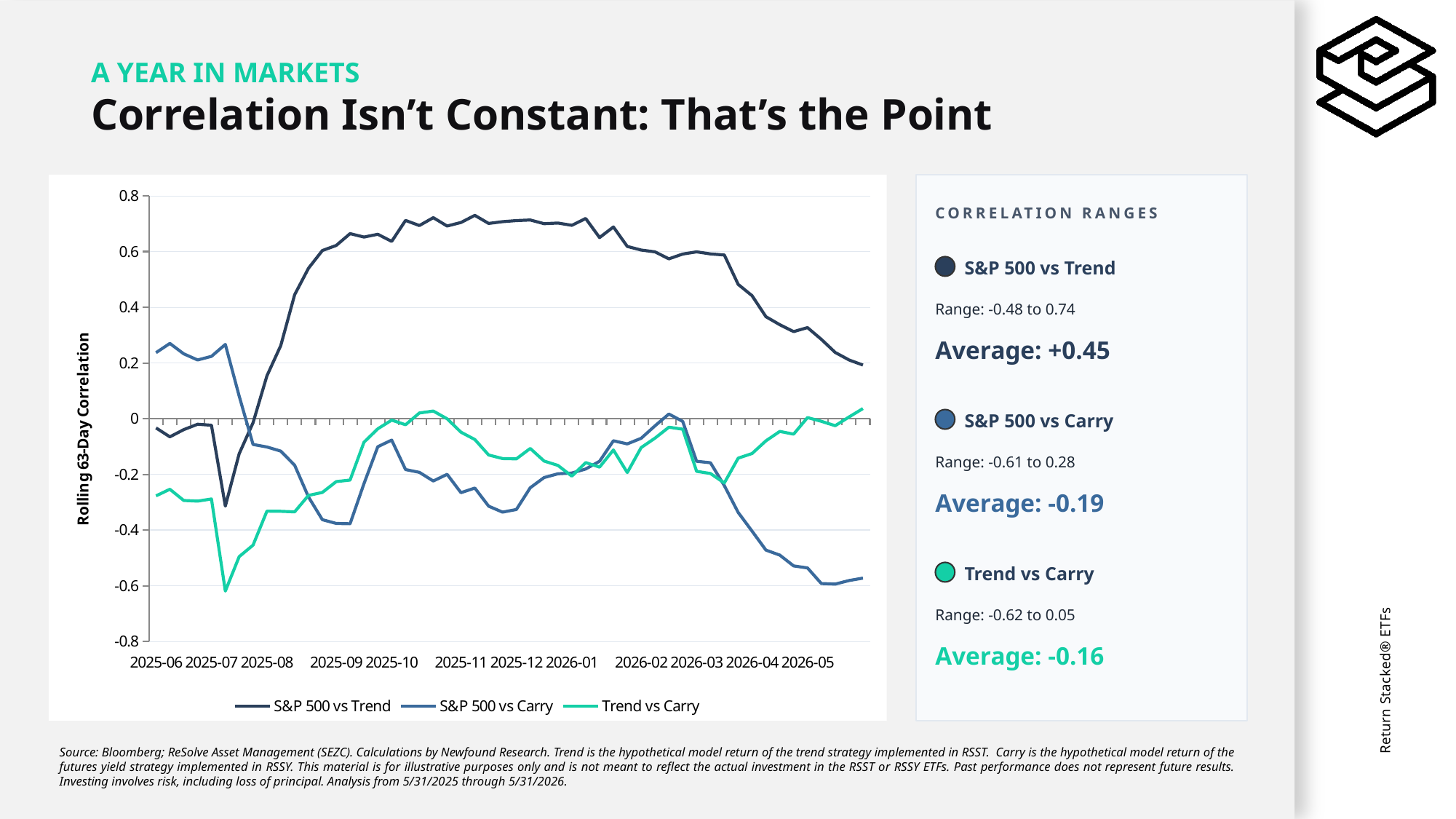
Which series reaches the highest value on the chart? S&P 500 vs Trend According to the Correlation Ranges panel, what is the range for S&P 500 vs Carry? -0.61 to 0.28 Is the value for S&P 500 vs Carry at 2026-05 greater or less than -0.4? less What kind of chart is shown on the slide? line chart According to the Correlation Ranges panel, what is the average correlation for S&P 500 vs Trend? +0.45 What is the label on the y axis of the chart? Rolling 63-Day Correlation According to the Correlation Ranges panel, what is the average correlation for Trend vs Carry? -0.16 Does the S&P 500 vs Trend line rise or fall from 2026-01 to 2026-05? fall Is the value for S&P 500 vs Trend at 2026-05 greater or less than 0? greater How many series does the chart legend list? 3 At 2025-11, which is larger: S&P 500 vs Trend or S&P 500 vs Carry? S&P 500 vs Trend Is the value for S&P 500 vs Trend at 2025-11 greater or less than 0.6? greater